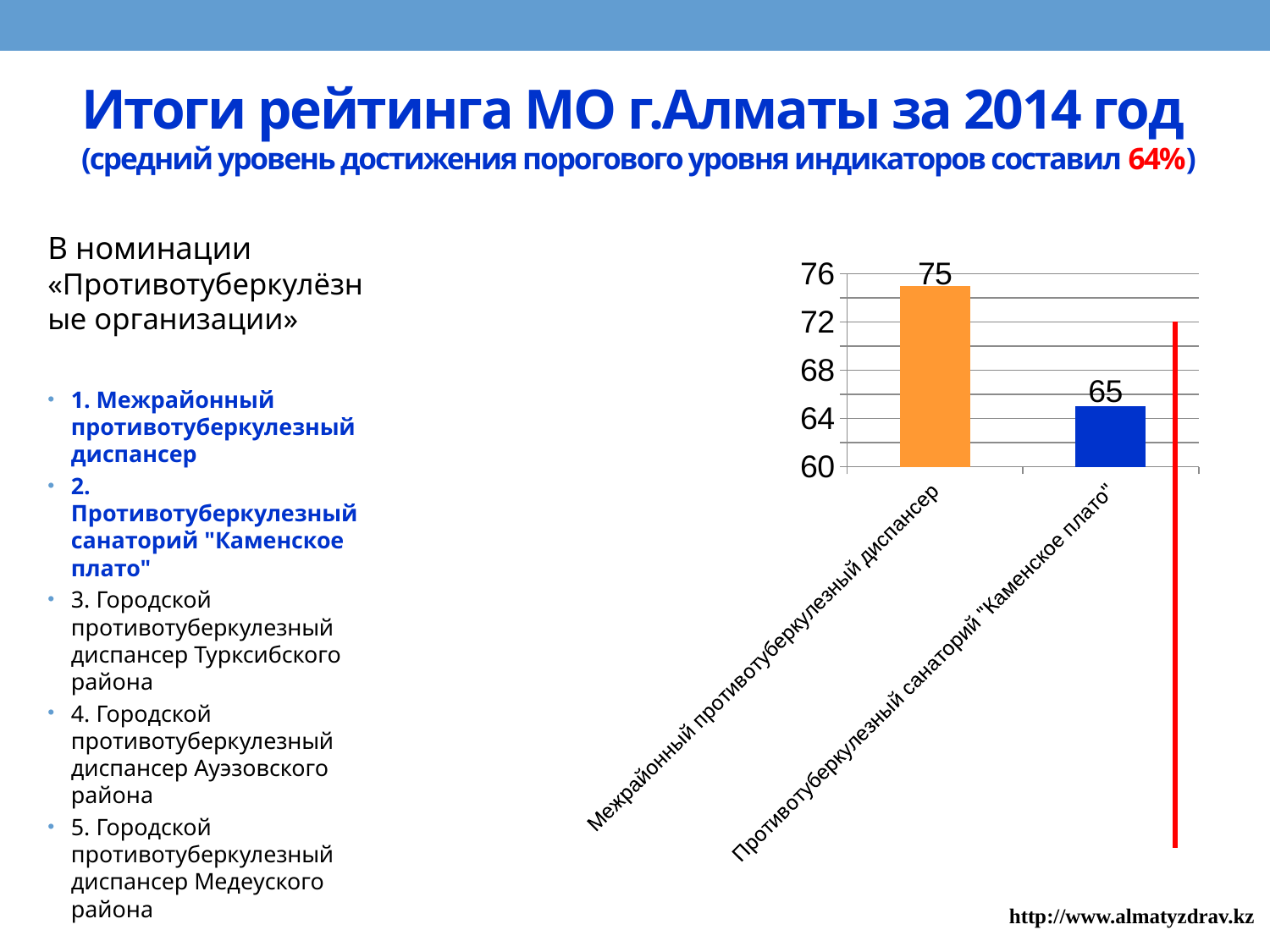
What is the difference between the values for Межрайонный противотуберкулезный диспансер and Противотуберкулезный санаторий "Каменское плато"? 10 What is the value for Противотуберкулезный санаторий "Каменское плато"? 65 Is the value for Межрайонный противотуберкулезный диспансер greater or less than 72? greater What kind of chart is shown on the slide? bar chart Is the value for Противотуберкулезный санаторий "Каменское плато" greater or less than 68? less Do the values rise or fall from left to right along the x axis? fall Which is larger: the value for Межрайонный противотуберкулезный диспансер or for Противотуберкулезный санаторий "Каменское плато"? Межрайонный противотуберкулезный диспансер What is the value for Межрайонный противотуберкулезный диспансер? 75 What colour is the bar for Межрайонный противотуберкулезный диспансер? orange Which category has the lowest value? Противотуберкулезный санаторий "Каменское плато" Which category has the highest value? Межрайонный противотуберкулезный диспансер How many categories are shown in the chart? 2